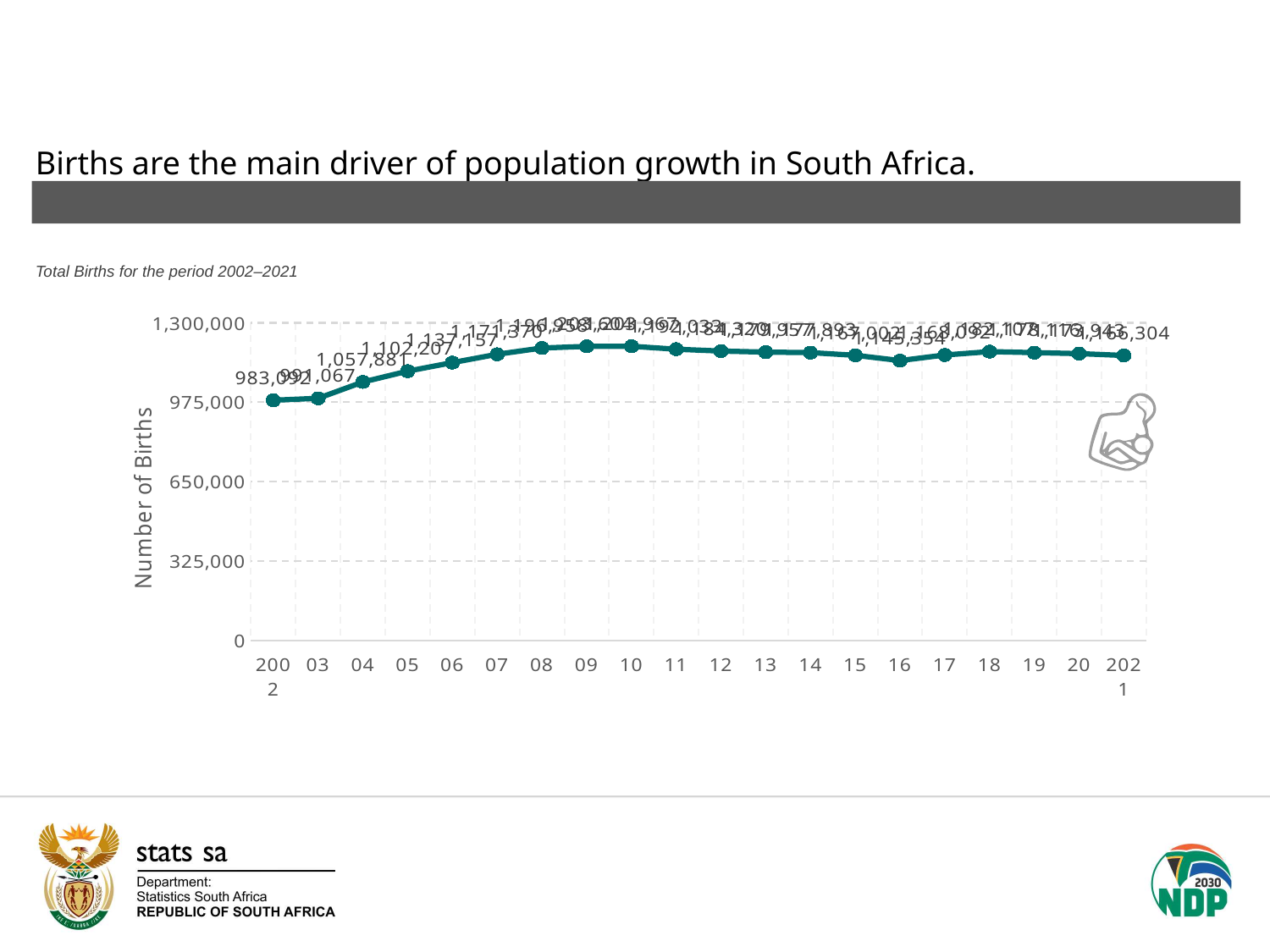
Which year has the lowest number of births? 2002 Is the value for 2010 greater or less than 975,000? greater What is the number of births for 2021? 1,166,304 What kind of chart is shown on the slide? Line chart How many years (data points) are plotted on the chart? 20 What is the number of births for 2004? 1,057,881 What is the difference in births between 2003 and 2002? 7,975 What is the label on the vertical axis of the chart? Number of Births Which year has more births, 2005 or 2004? 2005 What is the number of births for 2002? 983,092 What is the difference in births between 2004 and 2003? 66,814 Do the number of births rise or fall from 2002 to 2007? Rise